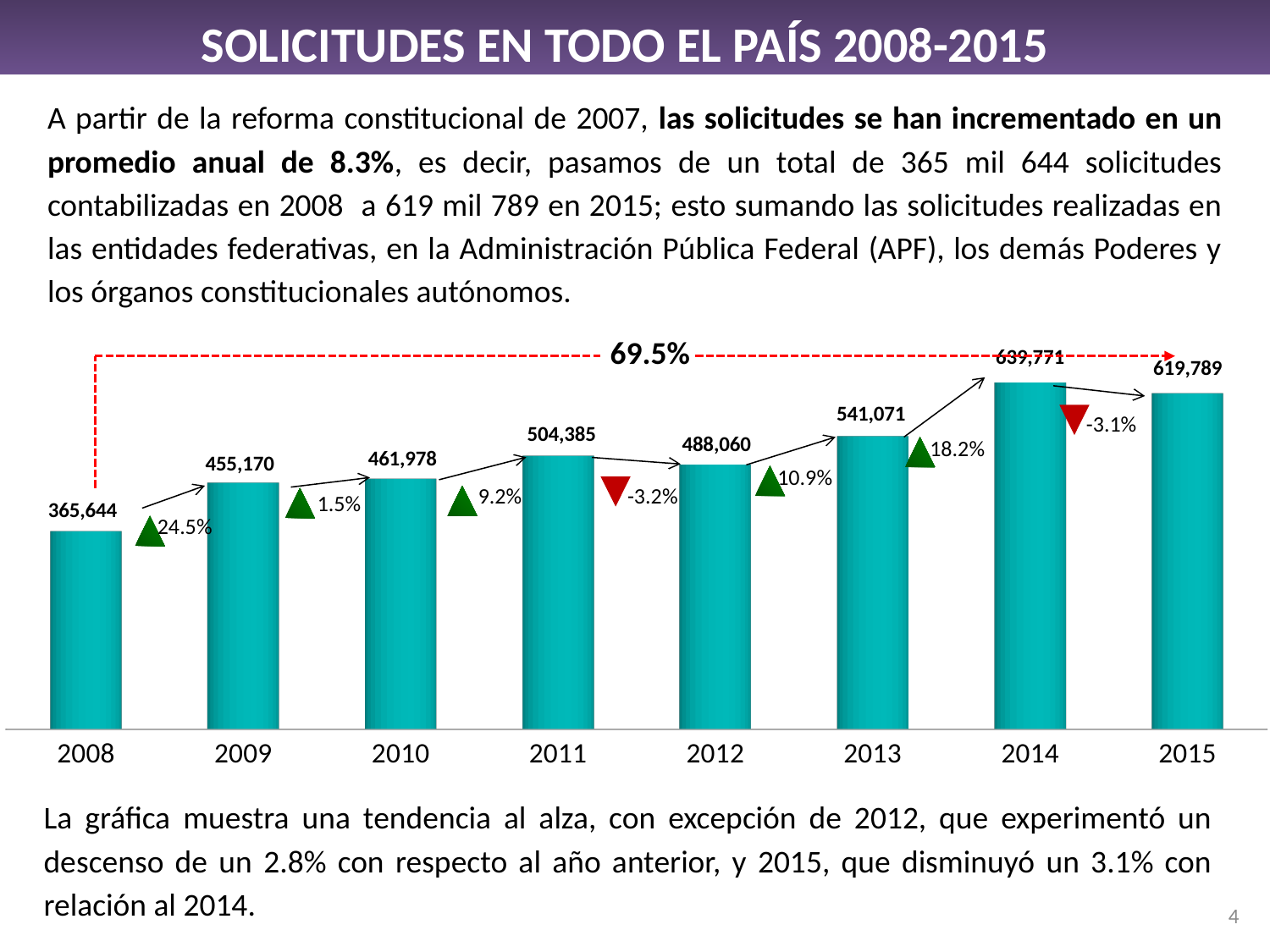
What is the difference between the values for 2014 and 2015? 19,982 What is the value shown for 2008? 365,644 Which year has the highest value? 2014 What is the value shown for 2012? 488,060 What kind of chart is shown on the slide? Bar chart How many years are shown on the x axis? 8 What is the value shown for 2015? 619,789 Which is larger, the value for 2011 or the value for 2012? 2011 What percentage change is labelled between 2013 and 2014? 18.2% Do the values generally rise or fall from 2008 to 2015? Rise What is the difference between the values for 2009 and 2008? 89,526 Which year has the lowest value? 2008